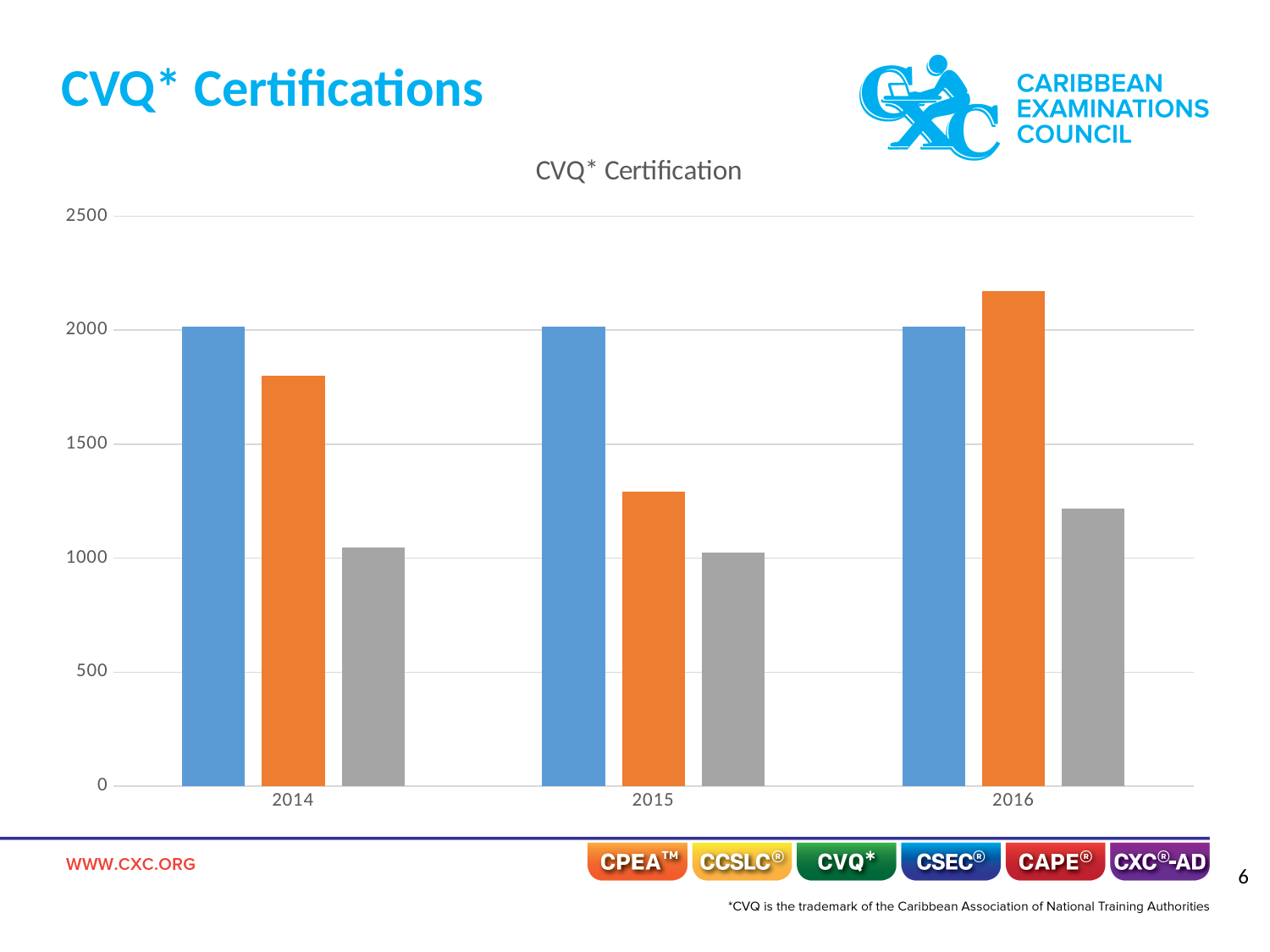
How many years are shown on the x axis of the chart? 3 Is the value of the orange bar for 2015 greater or less than 1500? less In which year is the orange bar the shortest? 2015 Is the value of the grey bar for 2016 greater or less than 1000? greater Is the value of the orange bar for 2016 greater or less than 2000? greater For 2016, which is larger, the blue bar or the orange bar? the orange bar What kind of chart is shown on the slide? bar chart In which year is the orange bar the tallest? 2016 What is the title of the chart? CVQ* Certification How many bars are plotted for each year in the chart? 3